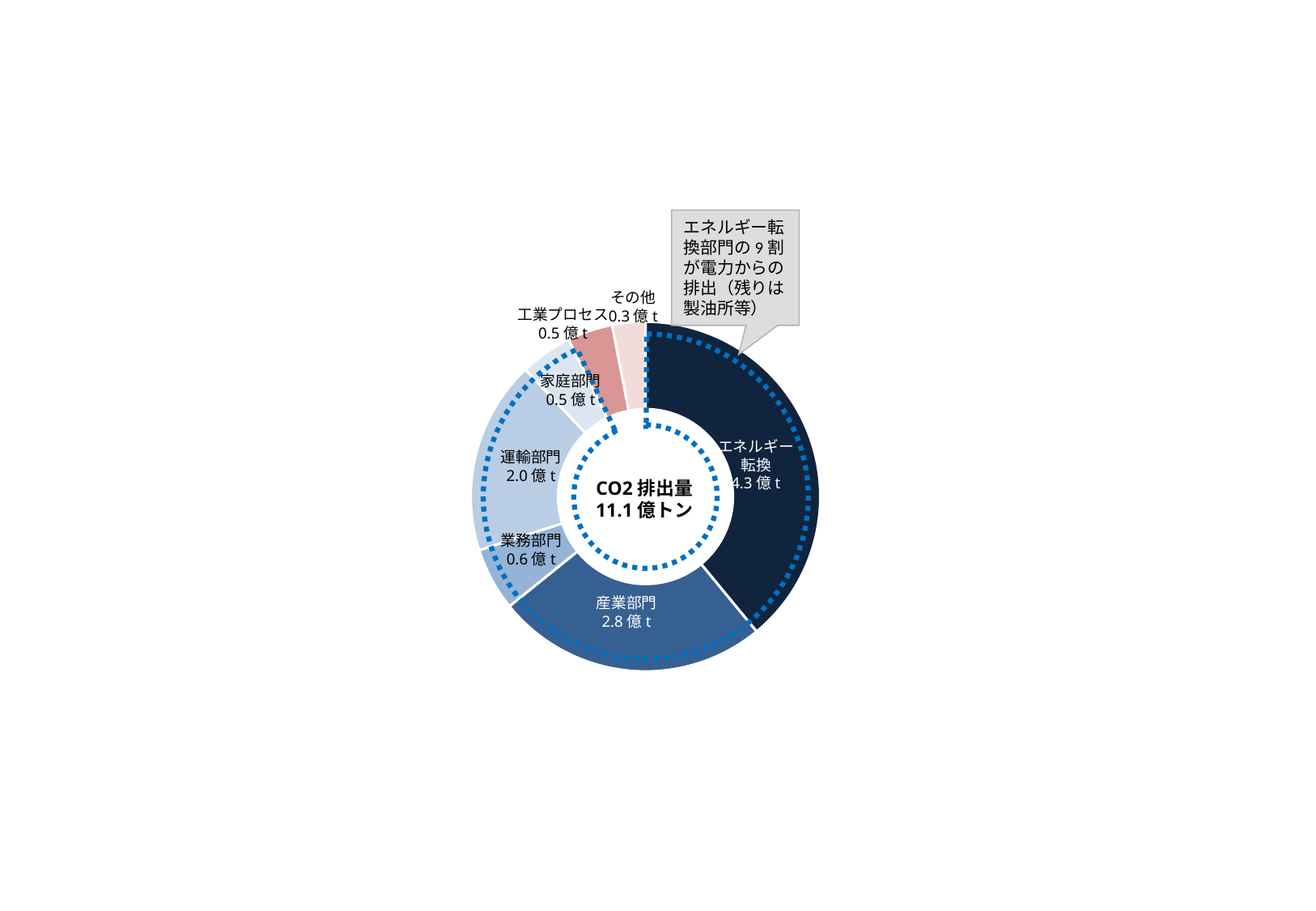
Which has higher CO2 emissions, 運輸部門 or 業務部門? 運輸部門 Which category has the smallest CO2 emissions in the chart? その他 What total CO2 emission amount is written in the center of the chart? 11.1 億トン What is the CO2 emission value for その他? 0.3 億 t Which sector has the largest CO2 emissions in the chart? エネルギー転換 What kind of chart is shown on the slide? Donut (pie) chart What is the CO2 emission value for 運輸部門? 2.0 億 t What is the CO2 emission value for 業務部門? 0.6 億 t How many segments does the donut chart have? 7 What is the CO2 emission value for エネルギー転換? 4.3 億 t What is the difference between the emissions of エネルギー転換 and 産業部門? 1.5 億 t What is the CO2 emission value for 産業部門? 2.8 億 t